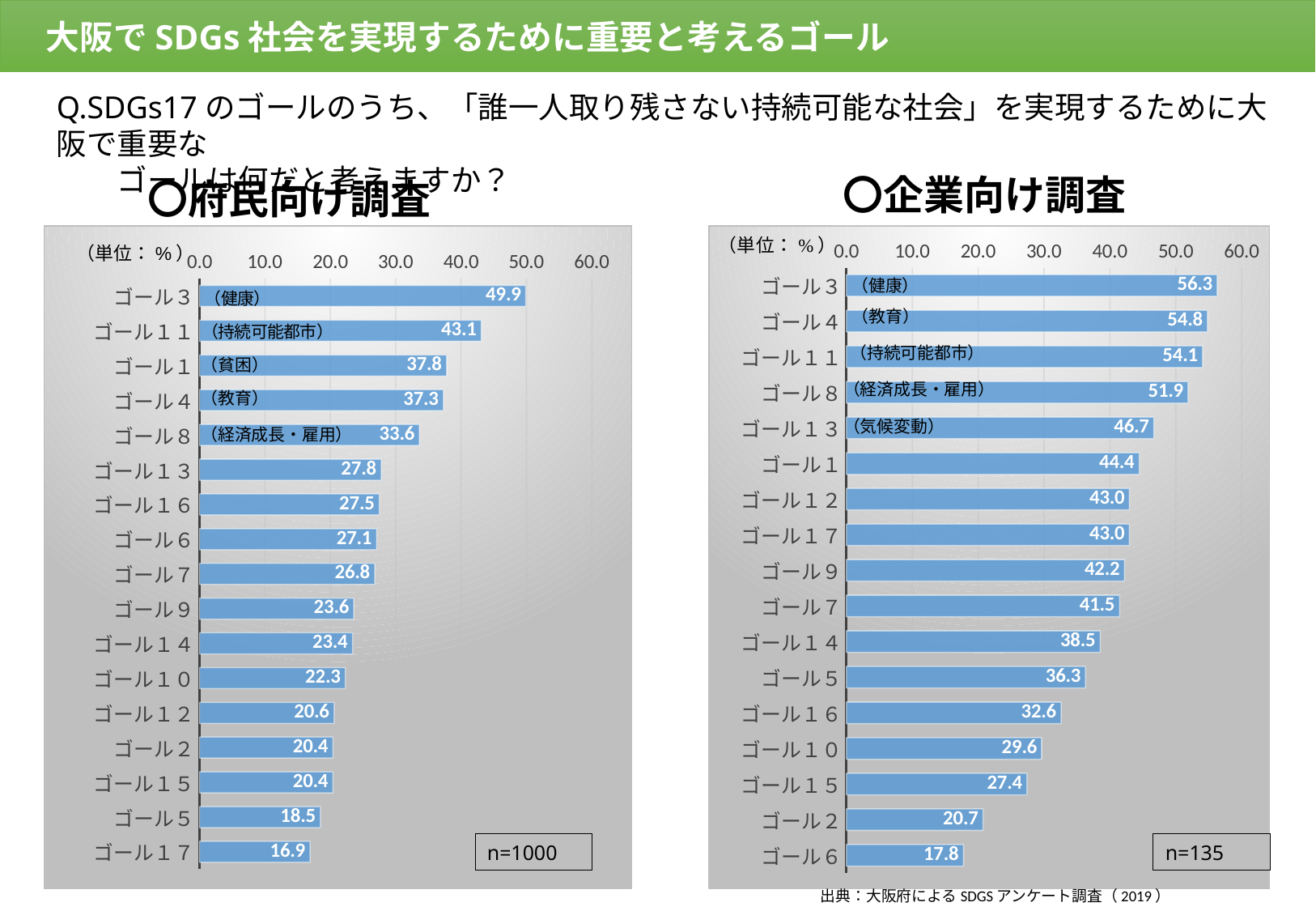
In the 府民向け調査 chart on the left, what is the value for ゴール３? 49.9 In the 企業向け調査 chart on the right, what is the value for ゴール１３? 46.7 In the 企業向け調査 chart on the right, which goal has the lowest value? ゴール６ In the 府民向け調査 chart on the left, which goal has the lowest value? ゴール１７ In the 企業向け調査 chart on the right, which goal has the highest value? ゴール３ How many goals are plotted in the 府民向け調査 chart on the left? 17 In the 府民向け調査 chart on the left, which is larger, the value for ゴール１ or the value for ゴール８? ゴール１ In the 府民向け調査 chart on the left, what is the difference between the values for ゴール３ and ゴール１１? 6.8 What kind of chart is the 企業向け調査 chart on the right? bar chart What sample size is shown in the box on the 企業向け調査 chart on the right? n=135 In the 企業向け調査 chart on the right, is the value for ゴール１４ greater or less than 40.0? less In the 企業向け調査 chart on the right, what is the difference between the values for ゴール４ and ゴール８? 2.9